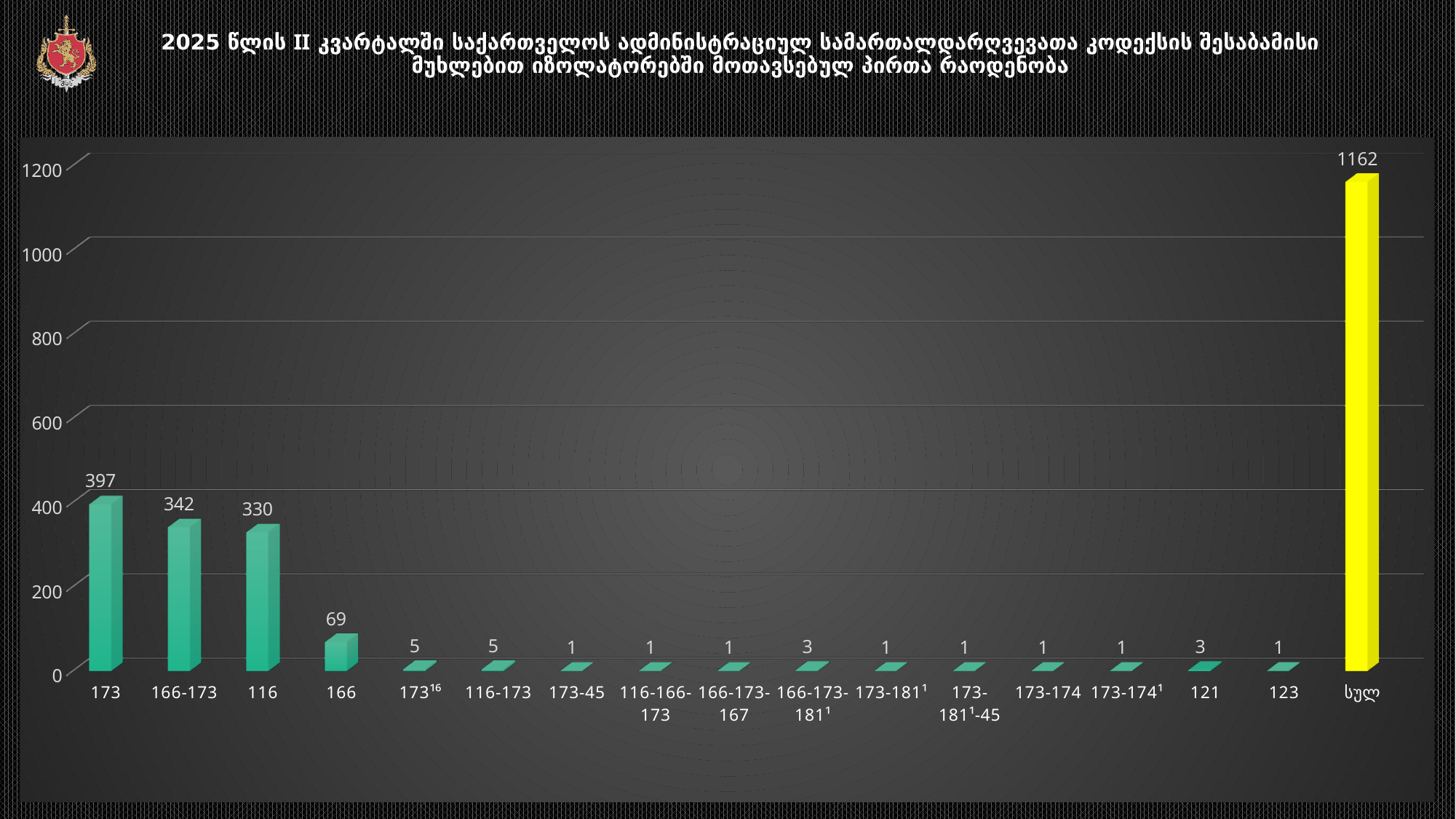
What kind of chart is shown on the slide? bar chart Excluding the სულ bar, which category has the highest value? 173 What is the difference between the values for 173 and 166-173? 55 What is the value for category 166-173? 342 What is the value for category 121? 3 What is the value for category 166? 69 Is the value for category 116 greater or less than 200? greater What is the value for the სულ bar? 1162 How many categories are shown on the x axis? 17 What is the value for category 173? 397 Which has a larger value, category 116 or category 166? 116 Which category has the highest bar on the chart? სულ